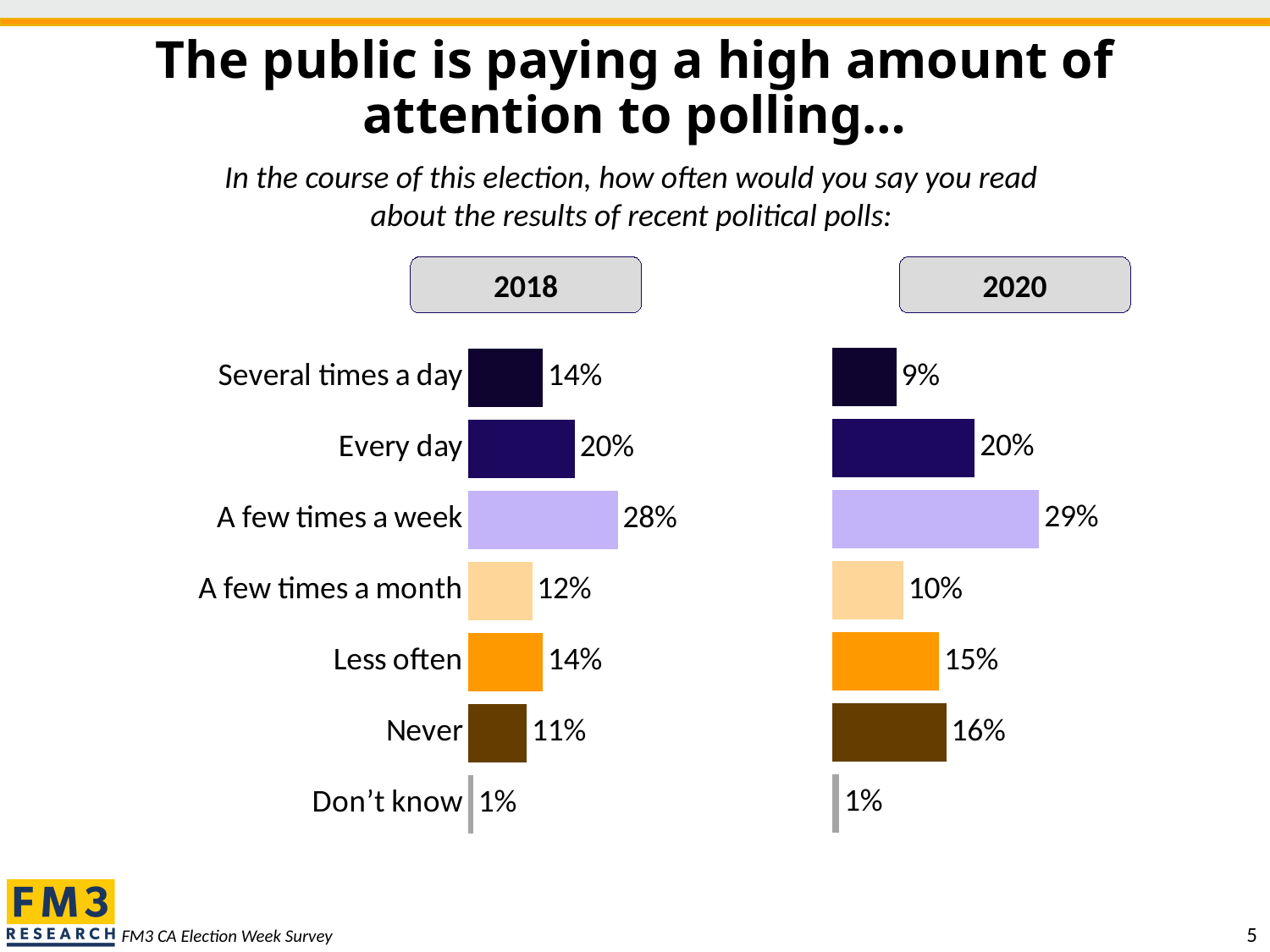
In the 2020 chart, what percentage said they read about poll results several times a day? 9% In the 2018 chart, what percentage said they read about poll results a few times a week? 28% In the 2018 chart, which is larger: 'Every day' or 'A few times a month'? Every day In the 2020 chart, what percentage said 'Never'? 16% In the 2020 chart, which category has the lowest value? Don't know What type of chart is used on this slide? Bar chart In the 2020 chart, what is the difference between 'A few times a week' and 'Every day'? 9 percentage points Which is larger: the 2018 value for 'Never' or the 2020 value for 'Never'? 2020 What is the difference between the 2018 and 2020 values for 'Several times a day'? 5 percentage points What are the two years compared in the charts on this slide? 2018 and 2020 In the 2018 chart, which category has the highest value? A few times a week How many categories are shown in each chart? 7